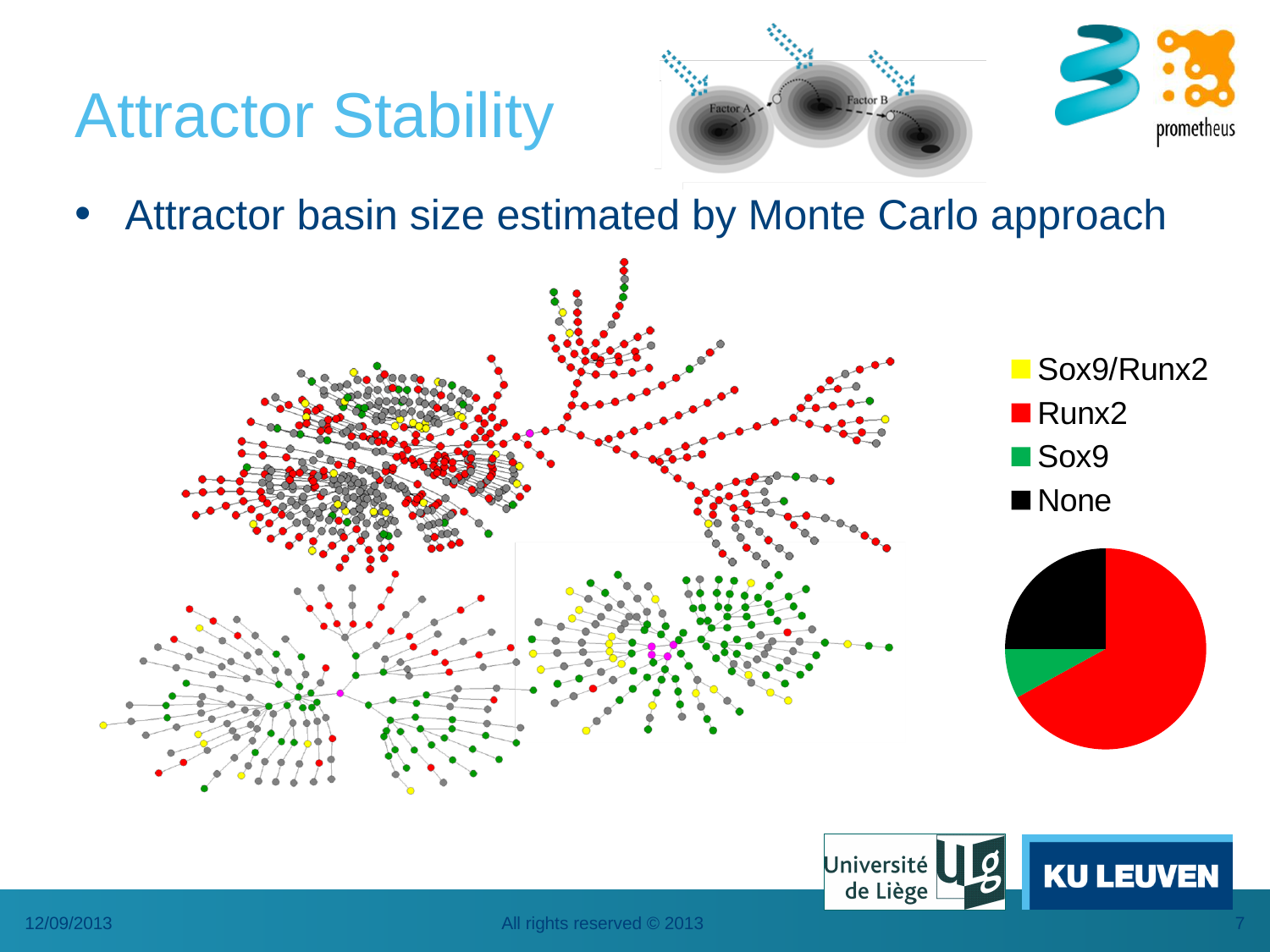
Does the Sox9 slice take up more or less than a quarter of the pie chart? less What kind of chart is shown on the right side of the slide below the legend? pie chart Which category has the largest slice in the pie chart? Runx2 In the pie chart, which slice is larger: Runx2 or None? Runx2 What colour represents None in the pie chart legend? black Does the Runx2 slice take up more or less than half of the pie chart? more In the pie chart, which slice is larger: None or Sox9? None In the pie chart, which slice is larger: Sox9 or Runx2? Runx2 How many entries does the legend of the pie chart list? 4 What colour represents Runx2 in the pie chart legend? red